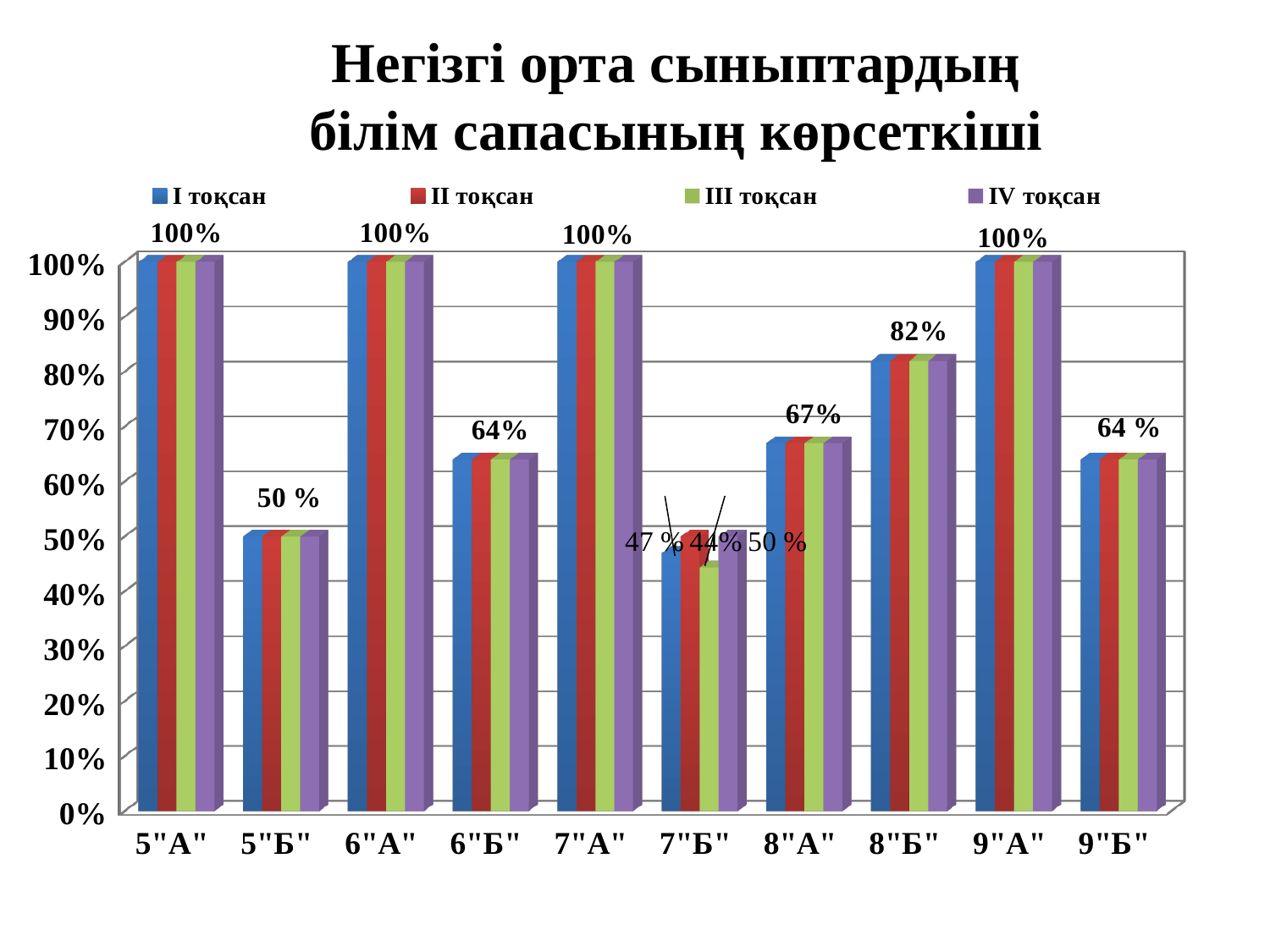
How many series does the legend list? 4 What value is labelled for class 5"Б"? 50 % What kind of chart is shown on the slide? bar chart What is the difference between the labelled values for 8"Б" and 6"Б"? 18% What value is labelled for class 6"Б"? 64% How many classes (categories) are shown on the x axis? 10 What value is labelled for class 8"А"? 67% Are the values for class 7"Б" greater or less than 60%? less Which class has the higher labelled value, 8"А" or 8"Б"? 8"Б" What value is labelled for class 8"Б"? 82% How many classes are labelled with 100%? 4 Which class has the lowest values on the chart? 7"Б"